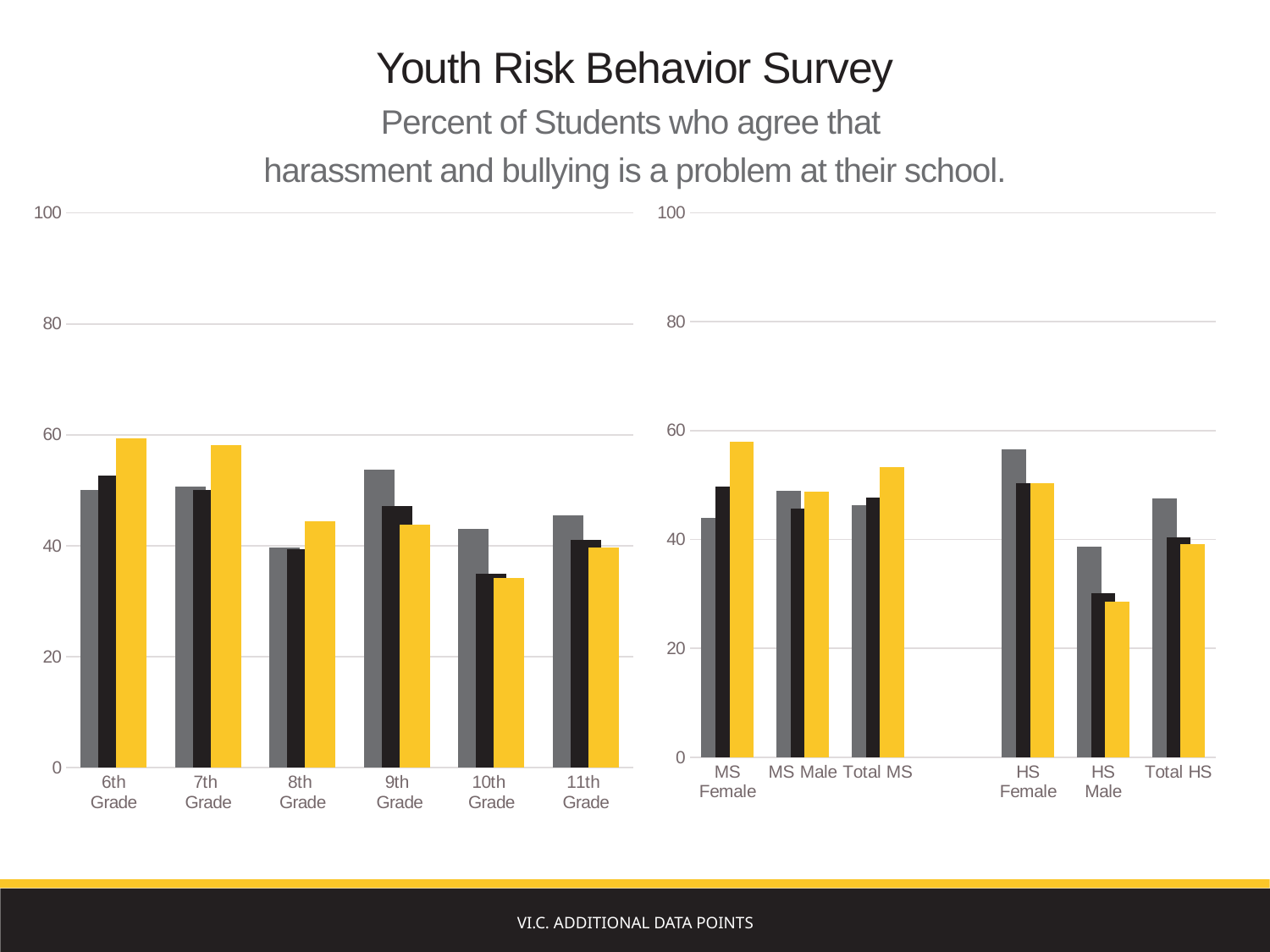
On the right chart, is the black bar for HS Male greater or less than 40? less On the left chart, which is larger: the gray bar for 9th Grade or the gray bar for 10th Grade? 9th Grade How many categories are shown on the right chart (MS/HS)? 6 On the left chart, which grade has the lowest yellow bar? 10th Grade How many grade categories are shown on the left chart? 6 On the left chart, is the yellow bar for 6th Grade greater or less than 40? greater What kind of chart is the left chart (by grade)? bar chart On the left chart, is the yellow bar for 10th Grade greater or less than 40? less On the right chart, which category has the lowest yellow bar? HS Male On the right chart, which is larger: the yellow bar for MS Female or the yellow bar for HS Male? MS Female What is the main title of the slide above the charts? Youth Risk Behavior Survey